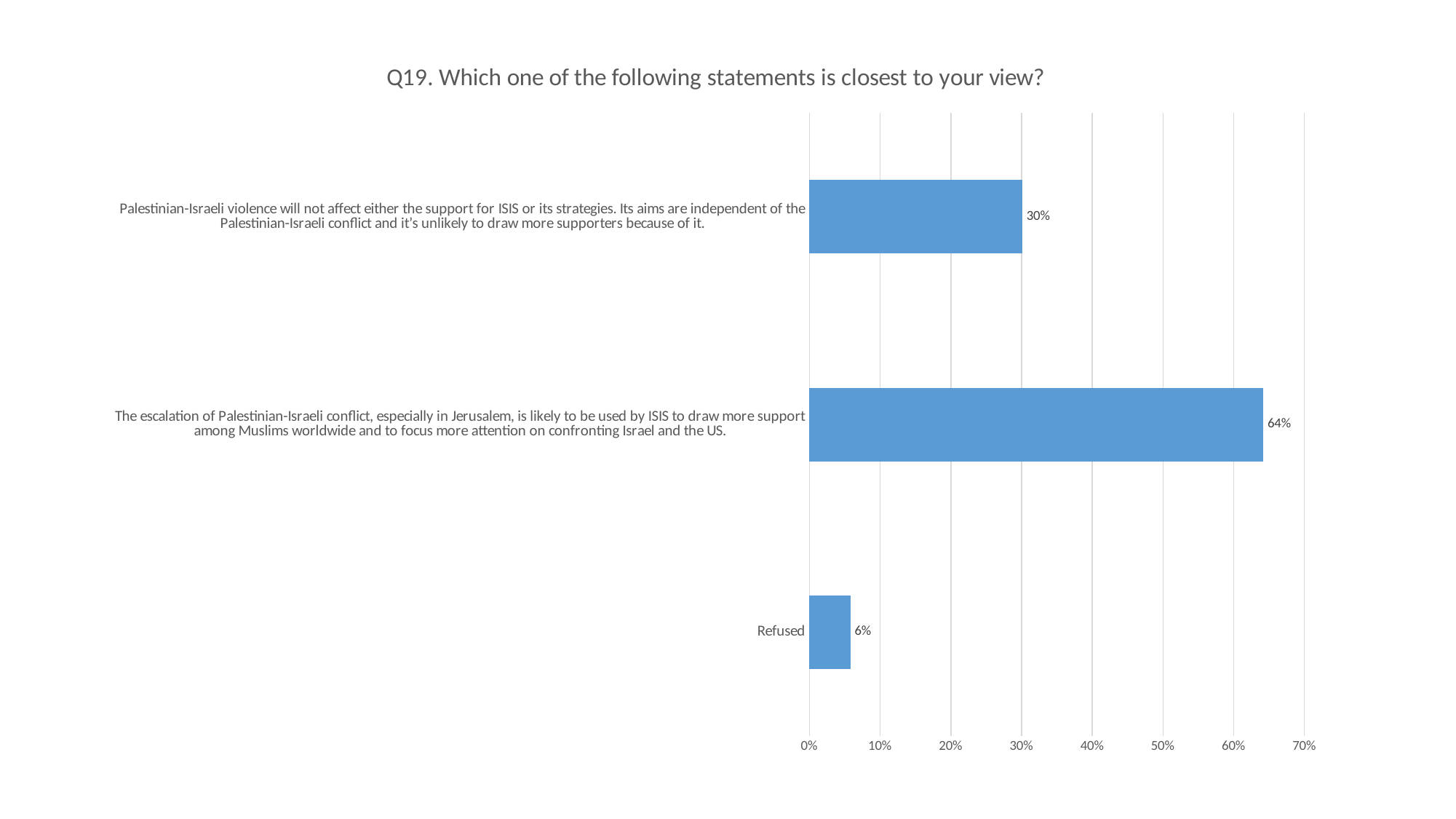
What percentage of respondents chose the statement that Palestinian-Israeli violence will not affect either the support for ISIS or its strategies? 30% Which response option has the lowest percentage? Refused Is the value for the statement that ISIS is likely to use the escalation to draw more support greater or less than 50%? greater Which is larger: the share for the statement that ISIS is likely to use the escalation to draw more support, or the share for the statement that violence will not affect support for ISIS? The escalation of Palestinian-Israeli conflict is likely to be used by ISIS to draw more support What type of chart is shown on the slide? Bar chart What percentage of respondents chose the statement that the escalation of the Palestinian-Israeli conflict is likely to be used by ISIS to draw more support? 64% What is the difference in percentage points between the two substantive statements (64% and 30%)? 34 percentage points What is the difference between the 'Refused' share and the share for the statement that violence will not affect support for ISIS? 24 percentage points How many response categories are shown in the chart? 3 What percentage of respondents refused to answer? 6% What is the title of the chart? Q19. Which one of the following statements is closest to your view?